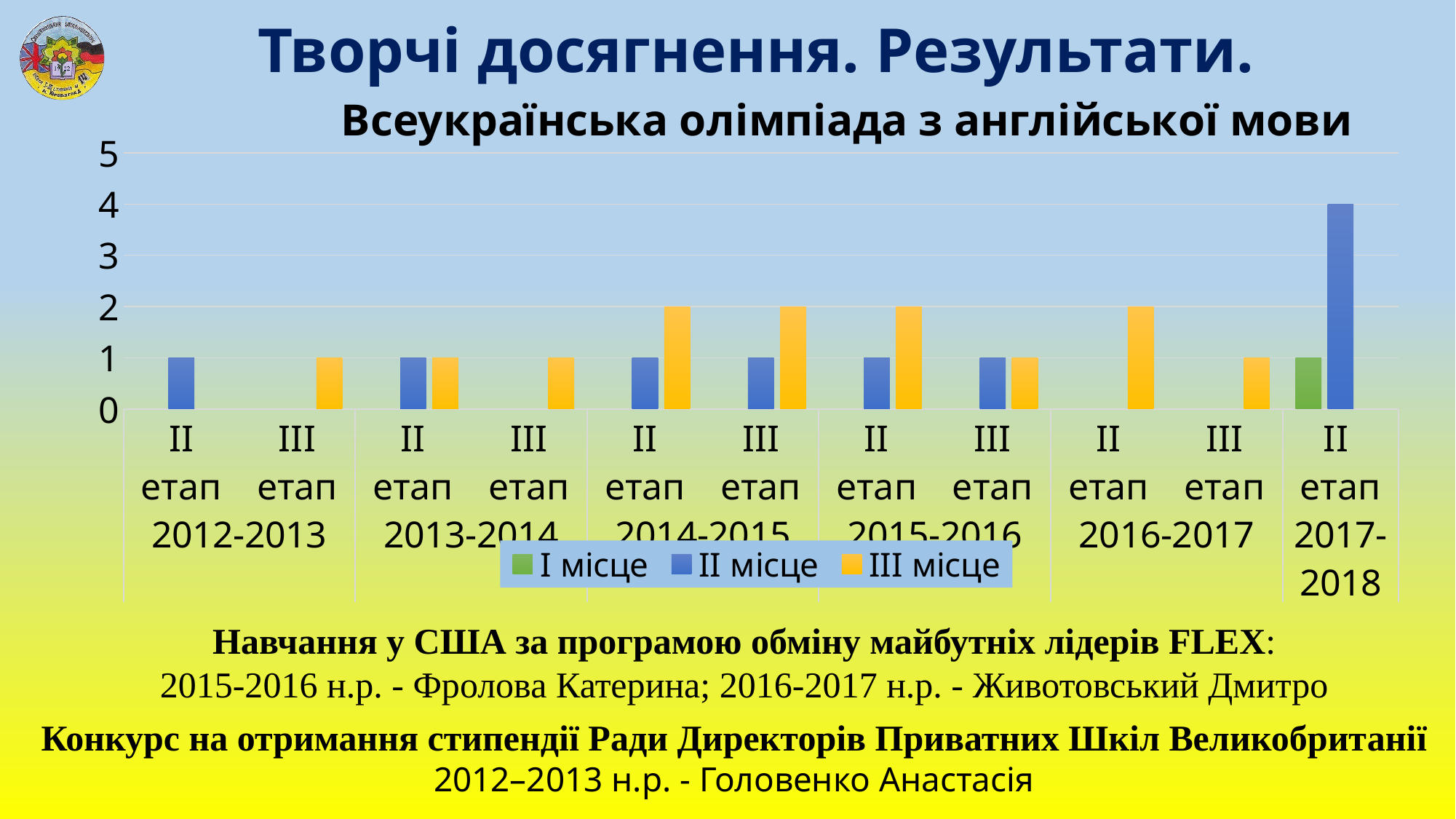
What is the title of the chart? Всеукраїнська олімпіада з англійської мови How many categories are shown along the x axis of the chart? 11 What is the value of the I місце bar for II етап 2017-2018? 1 What is the difference between the II місце value for II етап 2017-2018 and the II місце value for II етап 2012-2013? 3 What is the value of the III місце bar for II етап 2014-2015? 2 What kind of chart is shown on the slide? bar chart In which category does the II місце series reach its highest value? II етап 2017-2018 What is the value of the II місце bar for II етап 2017-2018? 4 Which colour represents the III місце series in the chart? orange Which is larger for III етап 2014-2015: the II місце bar or the III місце bar? III місце Is the II місце value for II етап 2017-2018 greater or less than 3? greater How many series does the chart legend list? 3